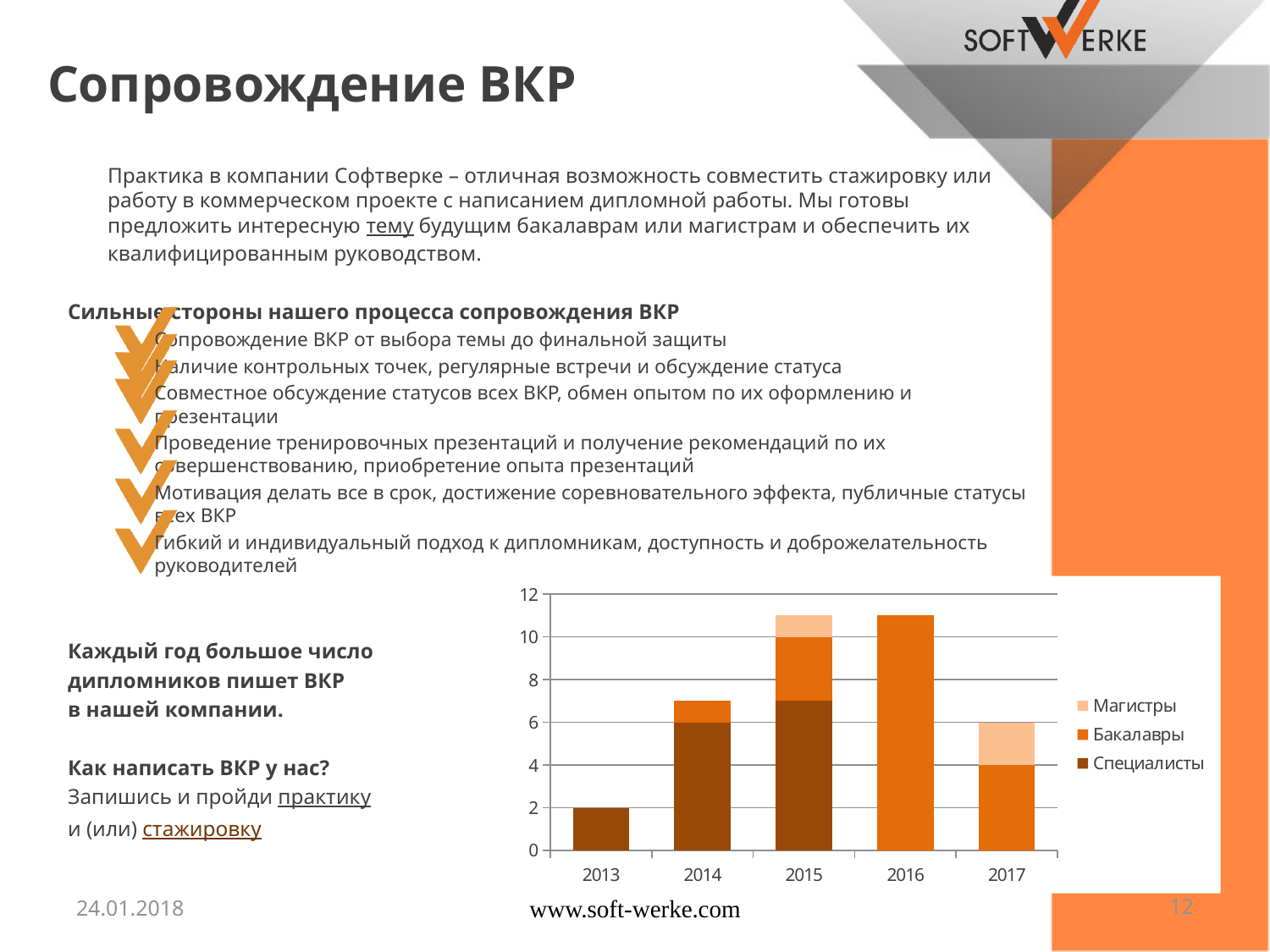
What is the value of Специалисты for 2014? 6 What is the total height of the bar for 2017? 6 How many years are shown on the x axis of the chart? 5 What kind of chart is shown on the slide? Stacked bar chart Which year has the larger total bar, 2016 or 2017? 2016 Is the total bar for 2014 greater or less than 6? greater Is the total bar for 2016 greater or less than 10? greater What is the total height of the bar for 2013? 2 How many series does the chart legend list? 3 Which series are listed in the chart legend? Магистры, Бакалавры, Специалисты Which year has the lowest total bar in the chart? 2013 Which year is the first to include a Магистры segment in its bar? 2015